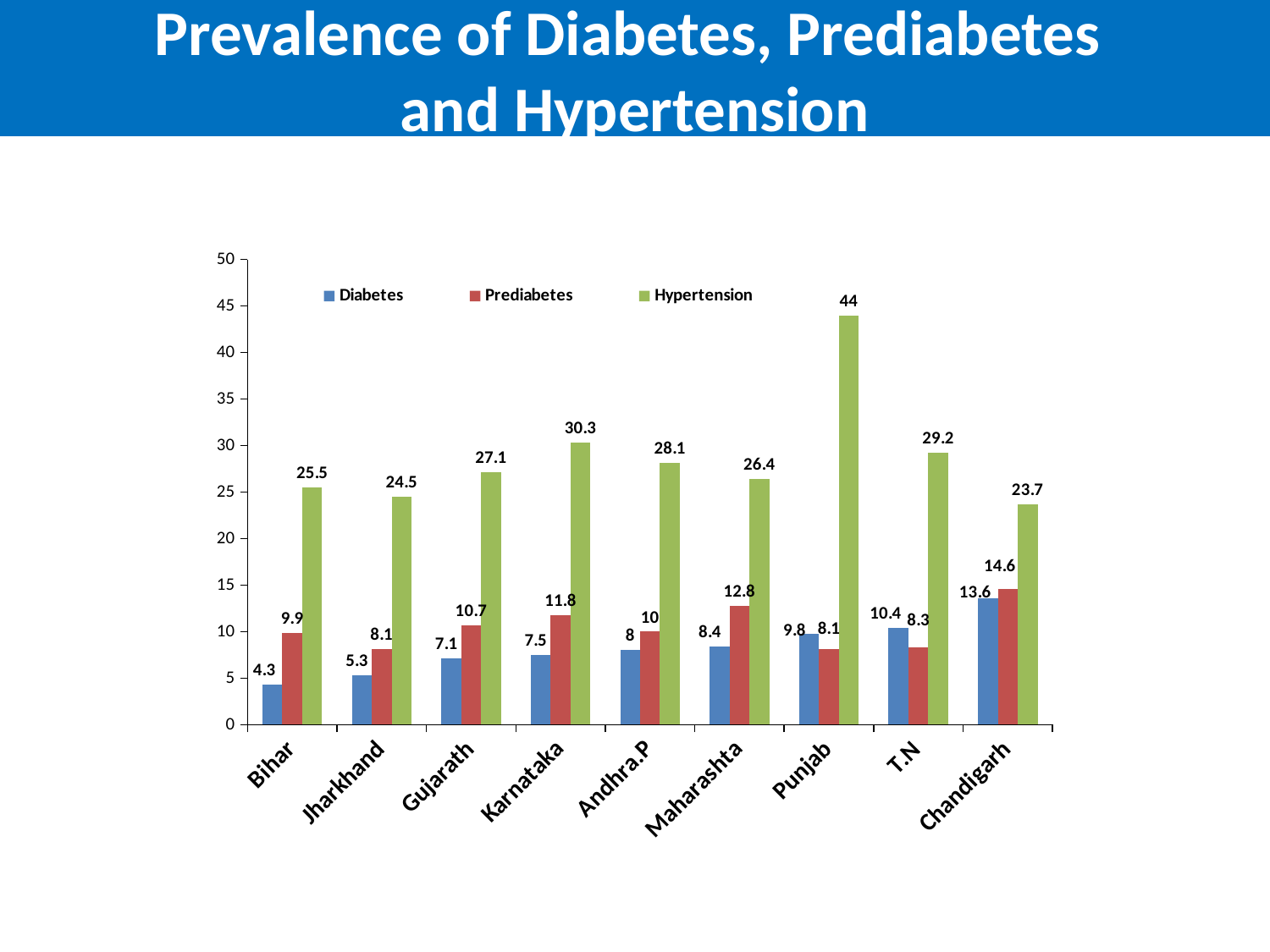
Which state has the highest Diabetes value? Chandigarh Which state has the lowest Diabetes value? Bihar What is the difference between the Hypertension values for Punjab and Chandigarh? 20.3 What is the Diabetes value for Bihar? 4.3 How many series does the legend list? 3 Which is larger, the Prediabetes value for Gujarath or the Prediabetes value for Jharkhand? Gujarath What is the title of the slide? Prevalence of Diabetes, Prediabetes and Hypertension What is the Prediabetes value for Maharashta? 12.8 Which state has the highest Hypertension value? Punjab What is the Hypertension value for Punjab? 44 How many states are shown on the x axis? 9 What kind of chart is shown on the slide? Bar chart